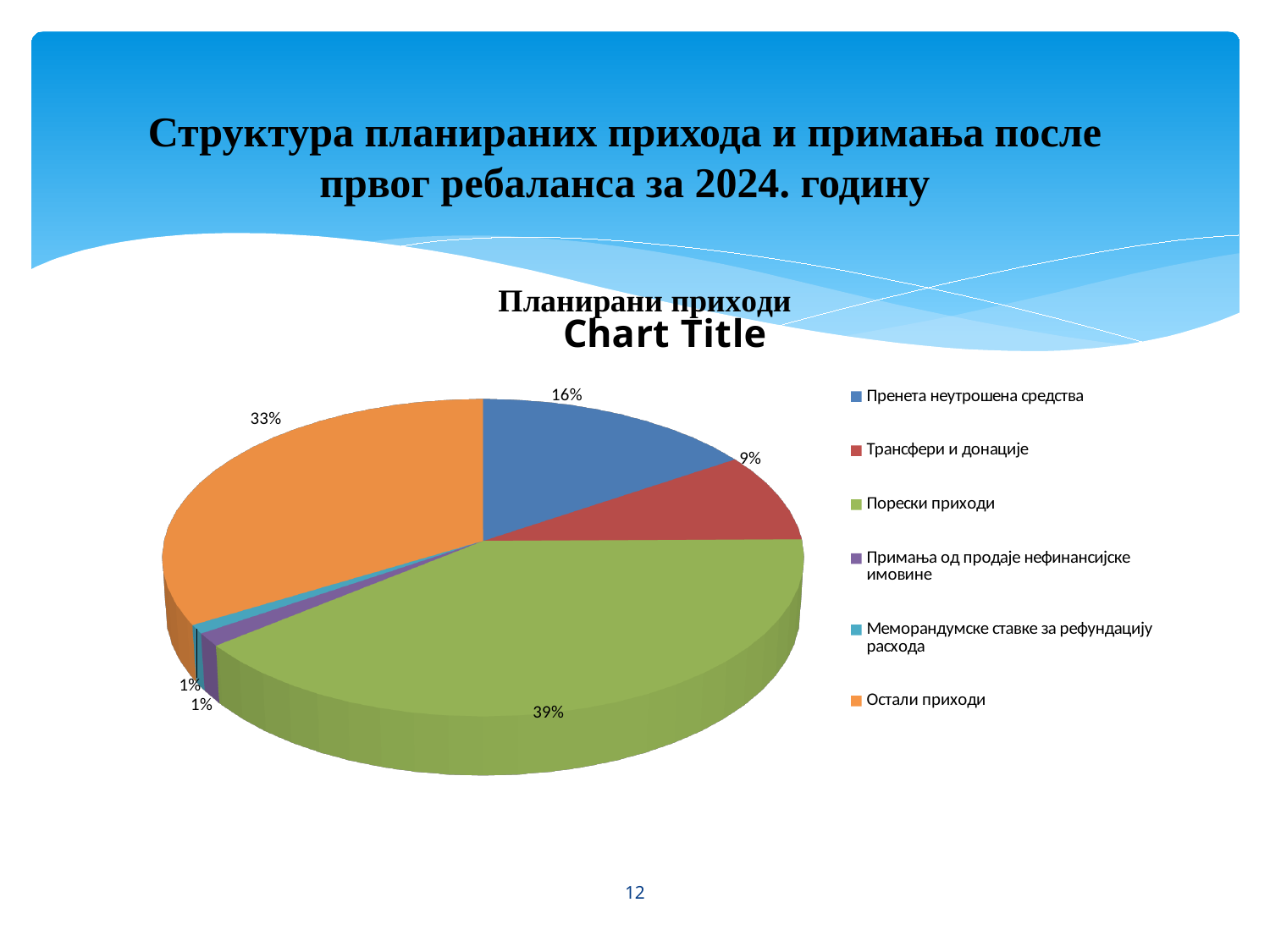
What share of the pie does Трансфери и донације have? 9% What colour is the slice for Остали приходи? orange What share of the pie does Пренета неутрошена средства have? 16% Which category has the largest slice of the pie? Порески приходи Which is larger, the share of Пренета неутрошена средства or the share of Трансфери и донације? Пренета неутрошена средства What share of the pie does Остали приходи have? 33% What is the difference between the shares of Порески приходи and Остали приходи? 6% How many categories does the legend list? 6 What is the combined share of Пренета неутрошена средства and Трансфери и донације? 25% What kind of chart is shown on the slide? pie chart